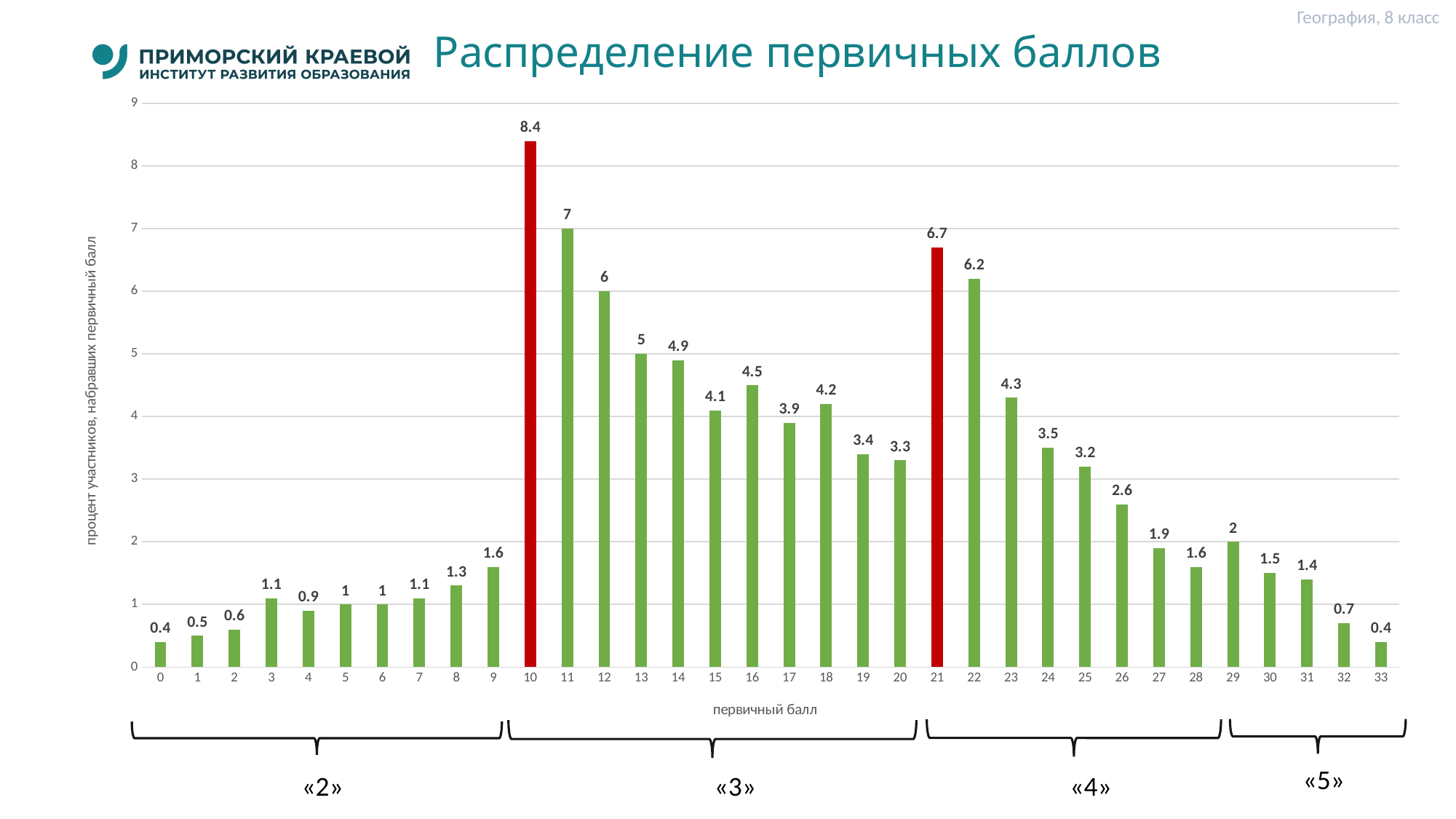
What is the title of the chart? Распределение первичных баллов What is the difference between the values for primary scores 10 and 21? 1.7 What kind of chart is shown on the slide? bar chart What is the difference between the values for primary scores 9 and 33? 1.2 Do the values rise or fall from primary score 22 to primary score 28? fall What is the value for primary score 21? 6.7 How many primary score categories are shown on the x axis? 34 What is the value for primary score 16? 4.5 Which two bars are coloured red? 10 and 21 Which primary score has the highest value? 10 What is the value for primary score 10? 8.4 Which is larger, the value for primary score 11 or for primary score 22? 11